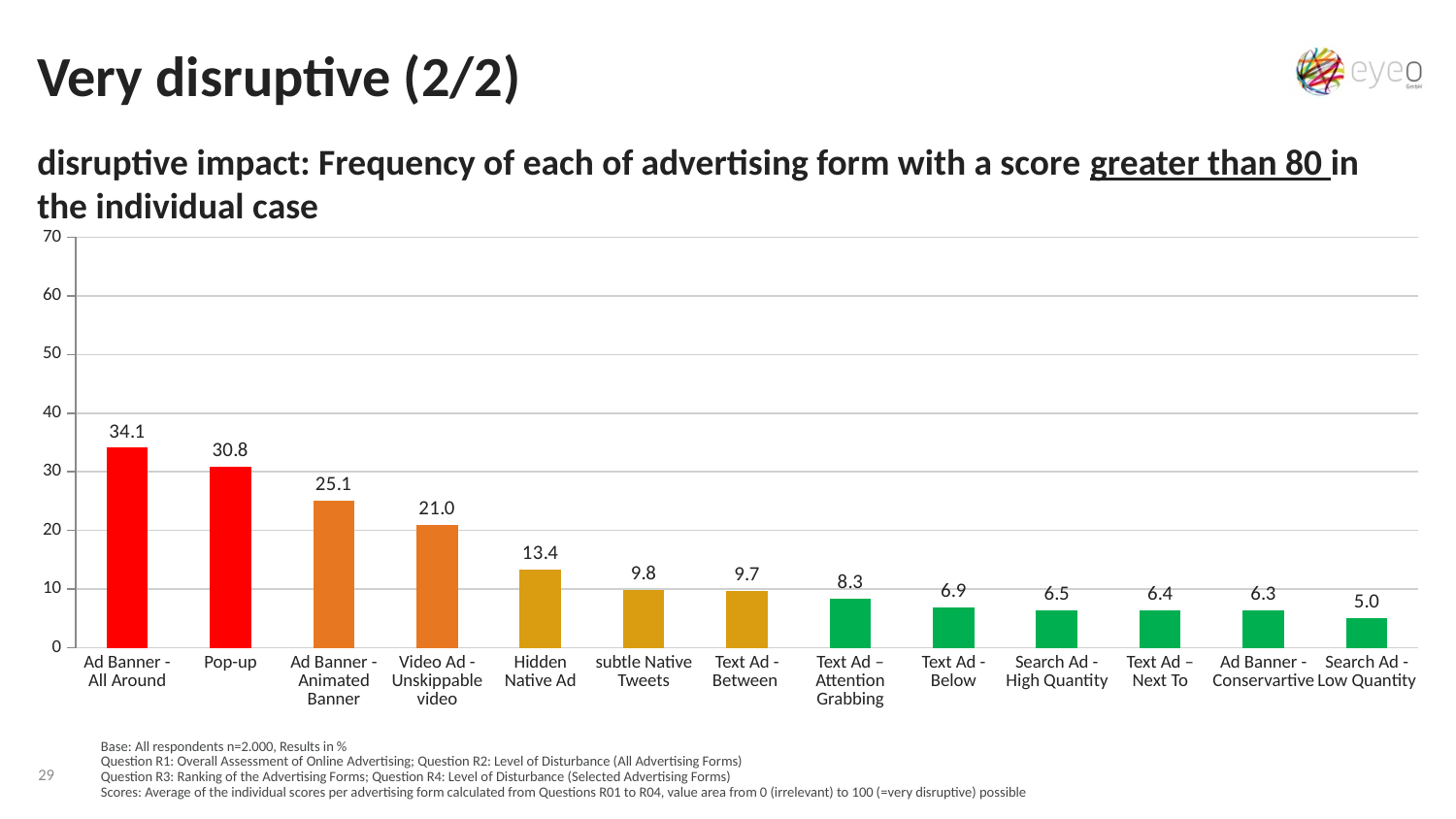
Do the values rise or fall from left to right along the x axis? fall Which is larger, the value for Hidden Native Ad or the value for subtle Native Tweets? Hidden Native Ad What kind of chart is shown on the slide? bar chart What is the difference between the values for Ad Banner - Animated Banner and Video Ad - Unskippable video? 4.1 What is the value for Search Ad - Low Quantity? 5.0 Which category has the lowest value? Search Ad - Low Quantity Which category has the highest value? Ad Banner - All Around What is the value for Hidden Native Ad? 13.4 Is the value for Video Ad - Unskippable video greater or less than 20? greater What is the difference between the values for Ad Banner - All Around and Pop-up? 3.3 How many categories are shown on the x axis? 13 What is the value for Pop-up? 30.8